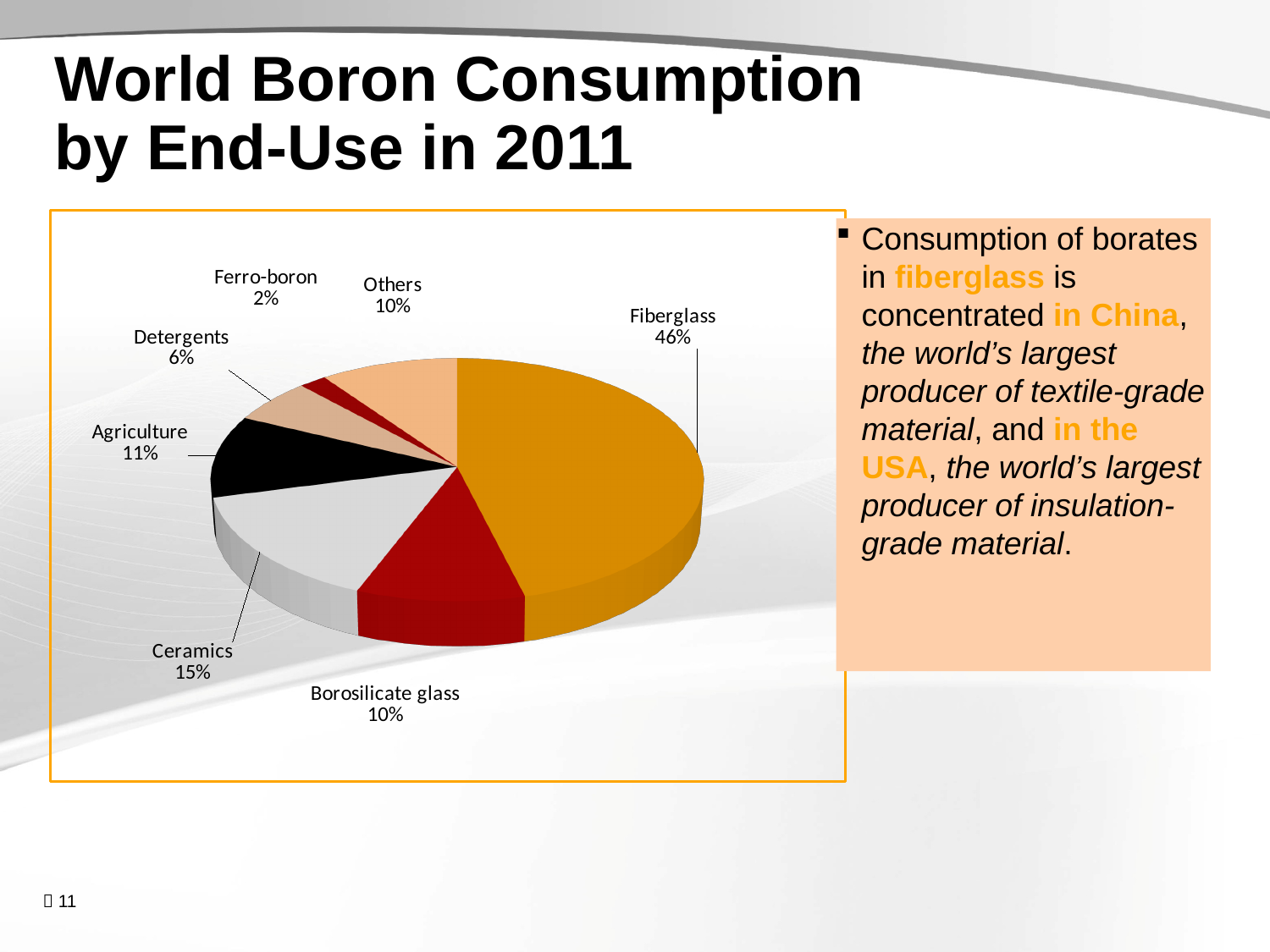
What is the share for Agriculture? 11% What is the difference in percentage points between Agriculture and Detergents? 5 How many end-use categories are shown in the pie chart? 7 What type of chart is shown on the slide? Pie chart Which has a larger share, Ceramics or Borosilicate glass? Ceramics What share of world boron consumption in 2011 is attributed to Fiberglass? 46% What is the title of the slide containing the chart? World Boron Consumption by End-Use in 2011 Which end-use has the largest share of world boron consumption? Fiberglass What is the share for Ferro-boron? 2% How many percentage points larger is the Fiberglass share than the Ceramics share? 31 Which end-use has the smallest share of world boron consumption? Ferro-boron What percentage of the pie does Ceramics account for? 15%